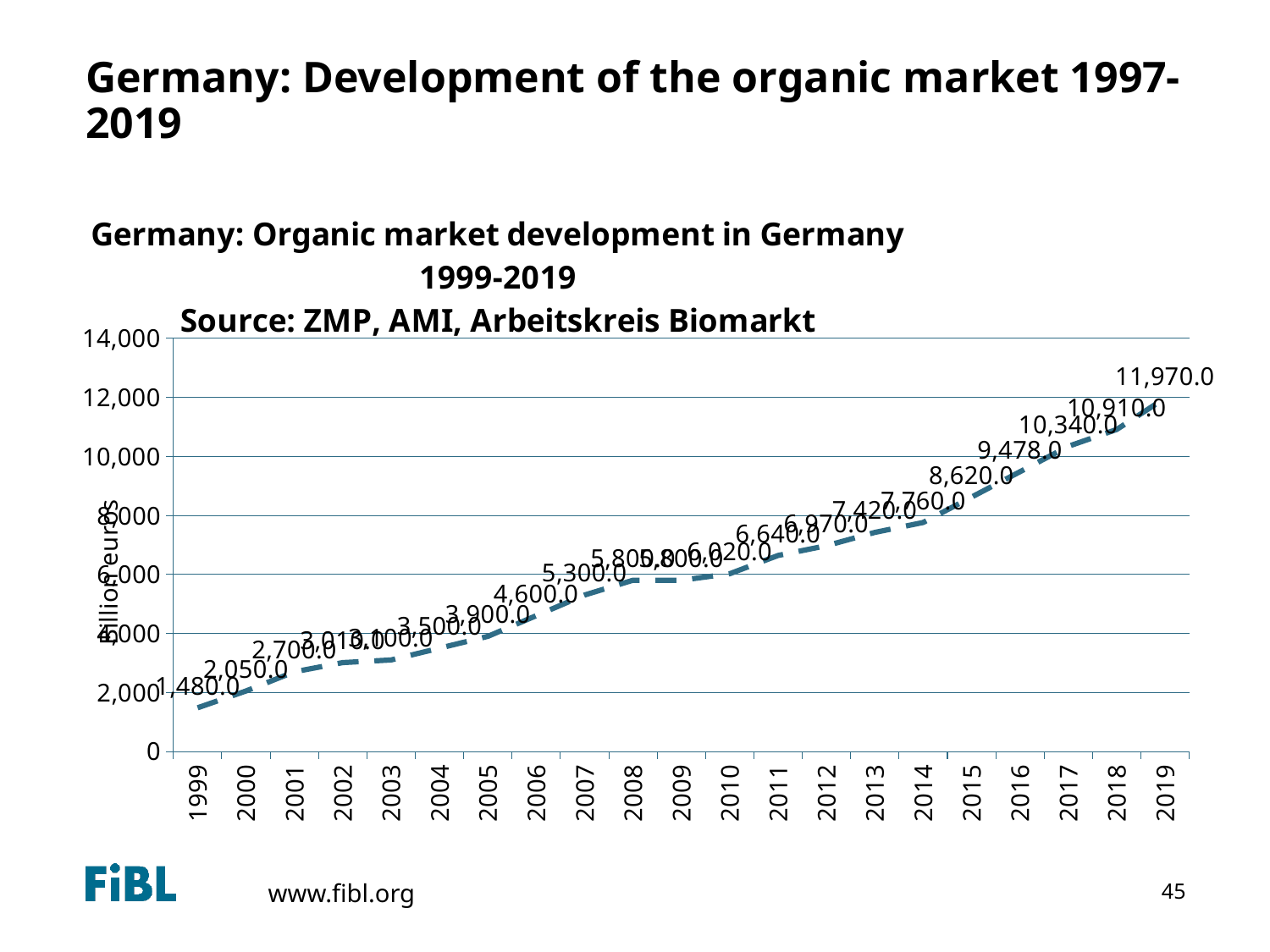
What is the value for 1999? 1,480.0 Which year has the lowest value? 1999 Which is larger, the value for 2013 or the value for 2011? 2013 How many years are plotted on the x axis? 21 What is the difference between the values for 2019 and 2018? 1,060.0 What is the value for 2006? 4,600.0 Is the value for 2012 greater or less than 6,000? greater Which year has the highest value? 2019 Do the values generally rise or fall from 1999 to 2019? Rise What is the value for 2019? 11,970.0 What is the value for 2016? 9,478.0 What type of chart is shown on the slide? Line chart